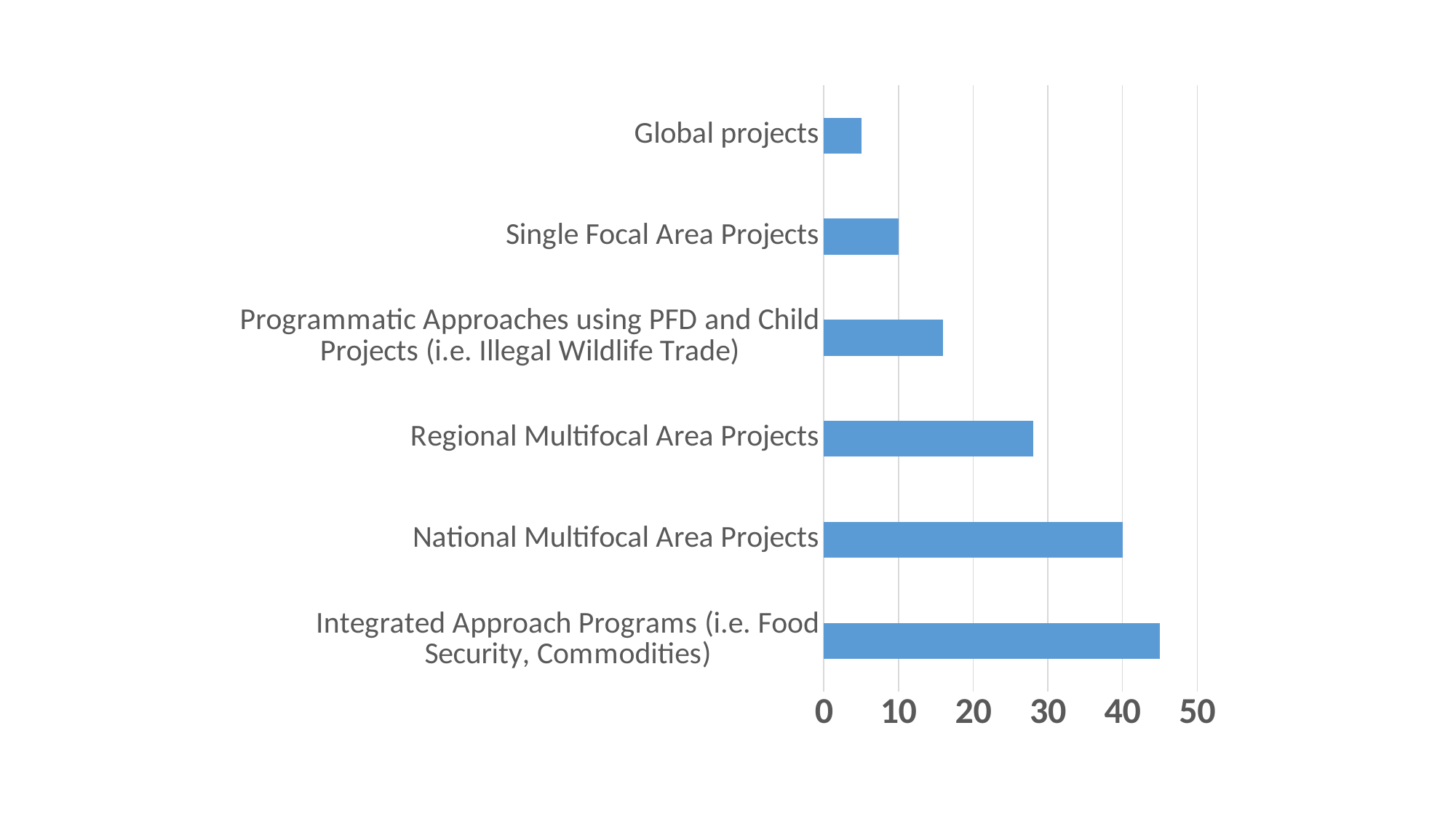
What is the value for Single Focal Area Projects? 10 What is the value for National Multifocal Area Projects? 40 Is the value for Global projects greater or less than 10? less Which category has the highest value? Integrated Approach Programs (i.e. Food Security, Commodities) Which is larger: the value for Regional Multifocal Area Projects or the value for Single Focal Area Projects? Regional Multifocal Area Projects Which category has the lowest value? Global projects How many categories are plotted in the chart? 6 What is the difference between the values for National Multifocal Area Projects and Single Focal Area Projects? 30 Is the value for Programmatic Approaches using PFD and Child Projects (i.e. Illegal Wildlife Trade) greater or less than 20? less Is the value for Regional Multifocal Area Projects greater or less than 20? greater What kind of chart is shown on the slide? bar chart